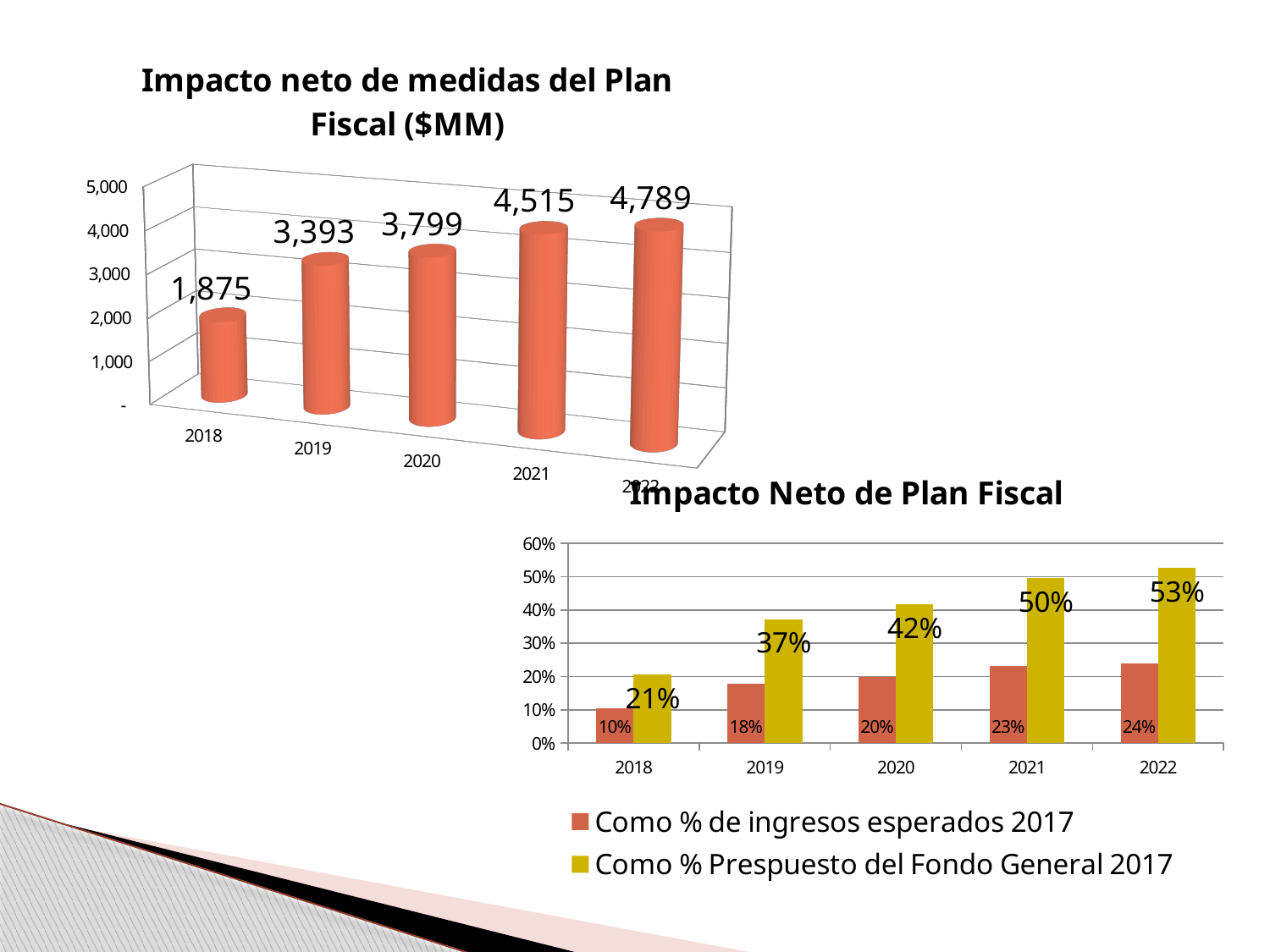
In the chart 'Impacto Neto de Plan Fiscal', what is the difference between the two series' values for 2022? 29% In the chart 'Impacto neto de medidas del Plan Fiscal ($MM)', what is the difference between the 2022 and 2018 values? 2,914 In the chart 'Impacto Neto de Plan Fiscal', what is the value of 'Como % Prespuesto del Fondo General 2017' for 2020? 42% In the chart 'Impacto neto de medidas del Plan Fiscal ($MM)', what is the value for 2020? 3,799 In the chart 'Impacto neto de medidas del Plan Fiscal ($MM)', which year has the highest value? 2022 In the chart 'Impacto Neto de Plan Fiscal', what is the value of 'Como % de ingresos esperados 2017' for 2021? 23% In the chart 'Impacto neto de medidas del Plan Fiscal ($MM)', do the values rise or fall from 2018 to 2022? rise In the chart 'Impacto Neto de Plan Fiscal', which series has the larger value for 2019? Como % Prespuesto del Fondo General 2017 How many years are shown in the chart 'Impacto neto de medidas del Plan Fiscal ($MM)'? 5 In the chart 'Impacto neto de medidas del Plan Fiscal ($MM)', which year has the lowest value? 2018 What kind of chart is 'Impacto Neto de Plan Fiscal'? bar chart How many series does the legend of the chart 'Impacto Neto de Plan Fiscal' list? 2